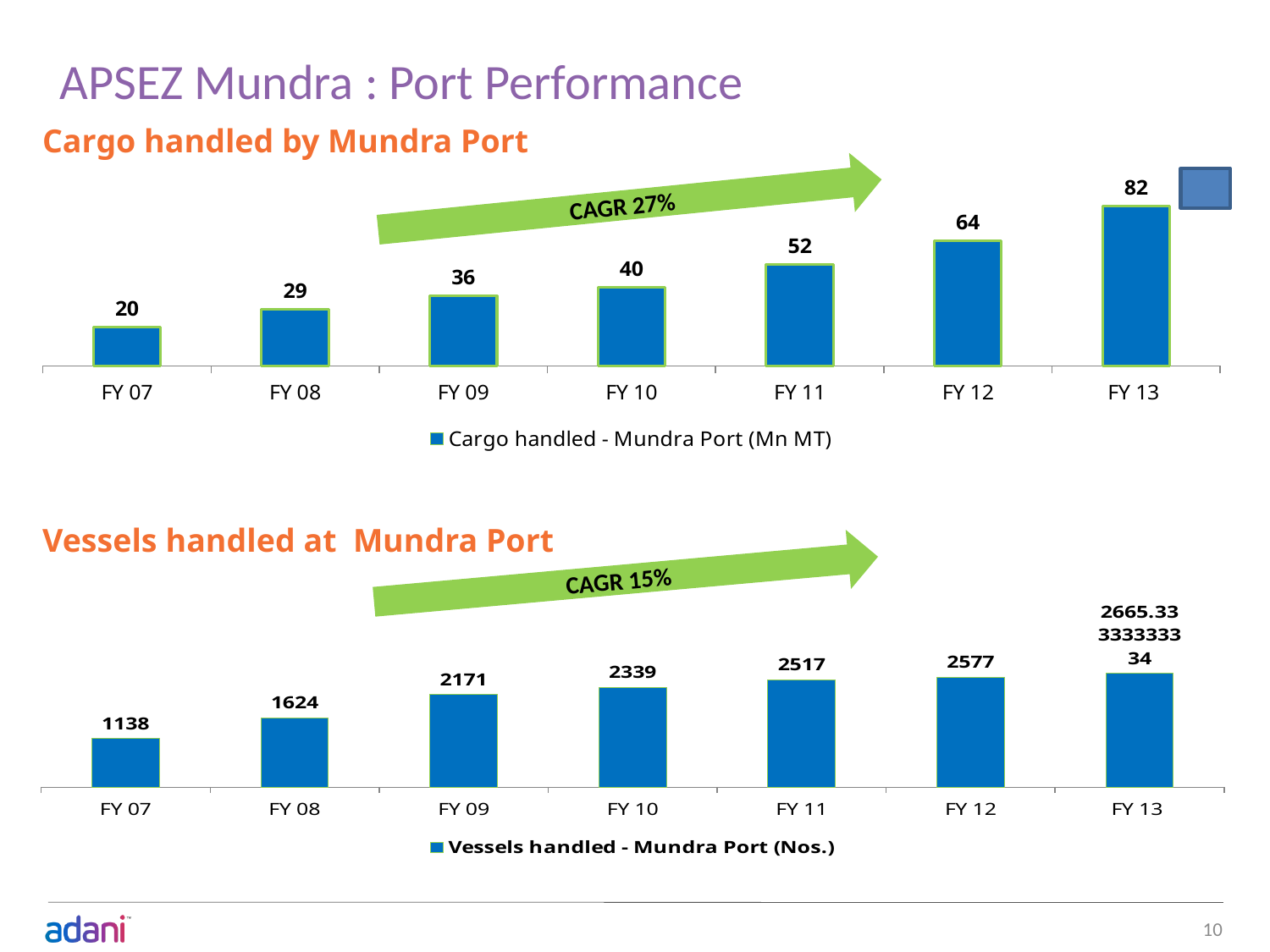
In the 'Vessels handled at Mundra Port' chart, what is the value for FY 09? 2171 In the 'Cargo handled by Mundra Port' chart, which fiscal year has the highest value? FY 13 In the 'Vessels handled at Mundra Port' chart, which is larger, the value for FY 08 or the value for FY 10? FY 10 In the 'Vessels handled at Mundra Port' chart, what is the value for FY 07? 1138 In the 'Cargo handled by Mundra Port' chart, how many fiscal years are shown on the x axis? 7 What type of chart is the 'Vessels handled at Mundra Port' chart? bar chart In the 'Vessels handled at Mundra Port' chart, what is the difference between the FY 11 and FY 10 values? 178 In the 'Cargo handled by Mundra Port' chart, which fiscal year has the lowest value? FY 07 In the 'Cargo handled by Mundra Port' chart, what is the value for FY 07? 20 In the 'Cargo handled by Mundra Port' chart, what is the value for FY 11? 52 In the 'Cargo handled by Mundra Port' chart, do the values rise or fall from FY 07 to FY 13? rise In the 'Cargo handled by Mundra Port' chart, what is the difference between the FY 13 and FY 12 values? 18